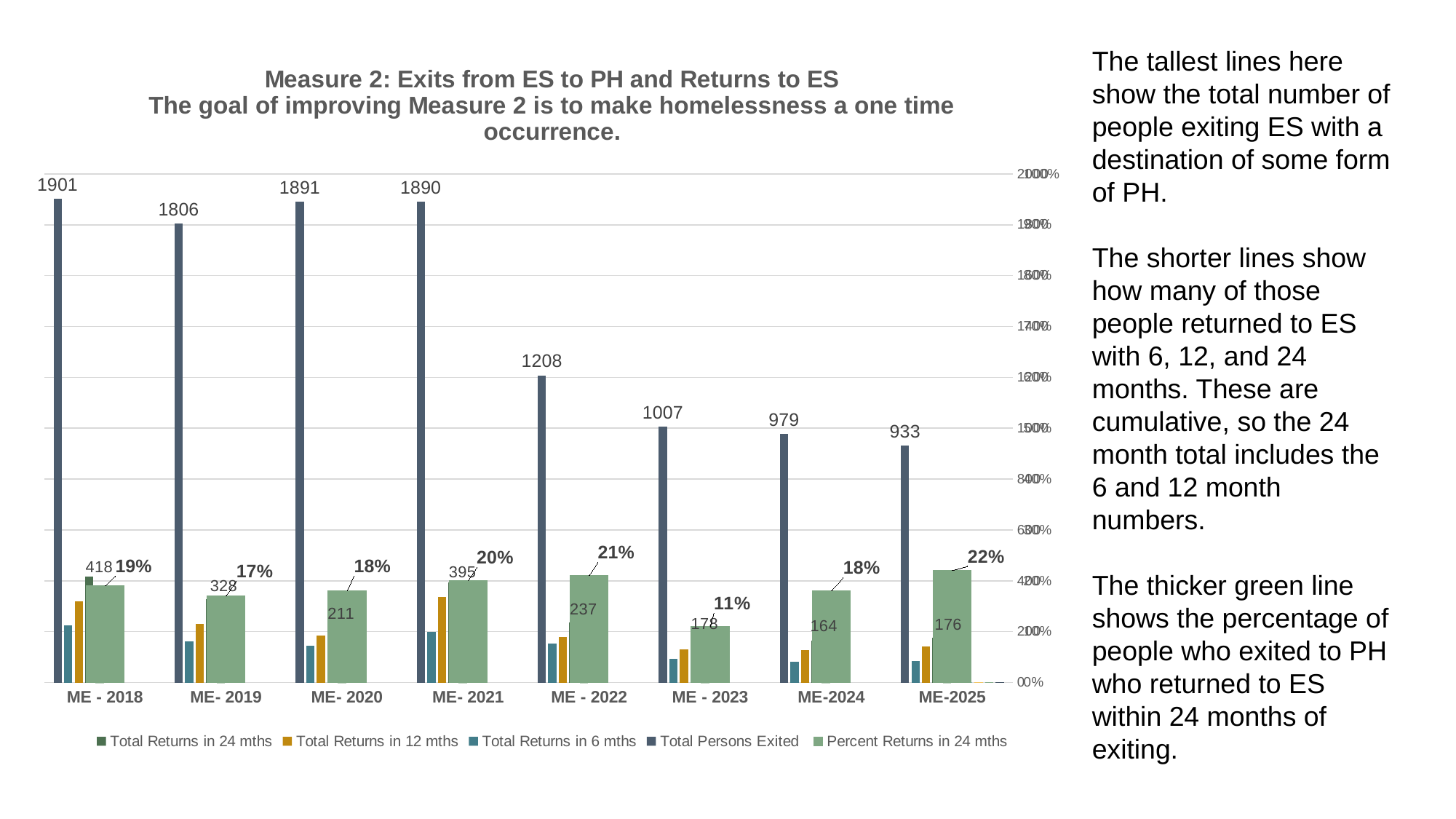
Which year has the highest Total Persons Exited? ME - 2018 What is the value of Total Returns in 24 mths for ME- 2021? 395 What is the difference in Total Persons Exited between ME - 2018 and ME-2025? 968 Which year has the highest Percent Returns in 24 mths? ME-2025 How many series does the chart's legend list? 5 What is the Percent Returns in 24 mths for ME-2025? 22% What kind of chart is shown on the slide? bar chart Which year has the lowest Percent Returns in 24 mths? ME - 2023 How many categories (years) are shown on the x axis of the chart? 8 What is the value of Total Persons Exited for ME - 2018? 1901 Does Total Persons Exited rise or fall from ME- 2021 to ME-2025? fall Which is larger, Total Persons Exited for ME- 2021 or for ME - 2022? ME- 2021